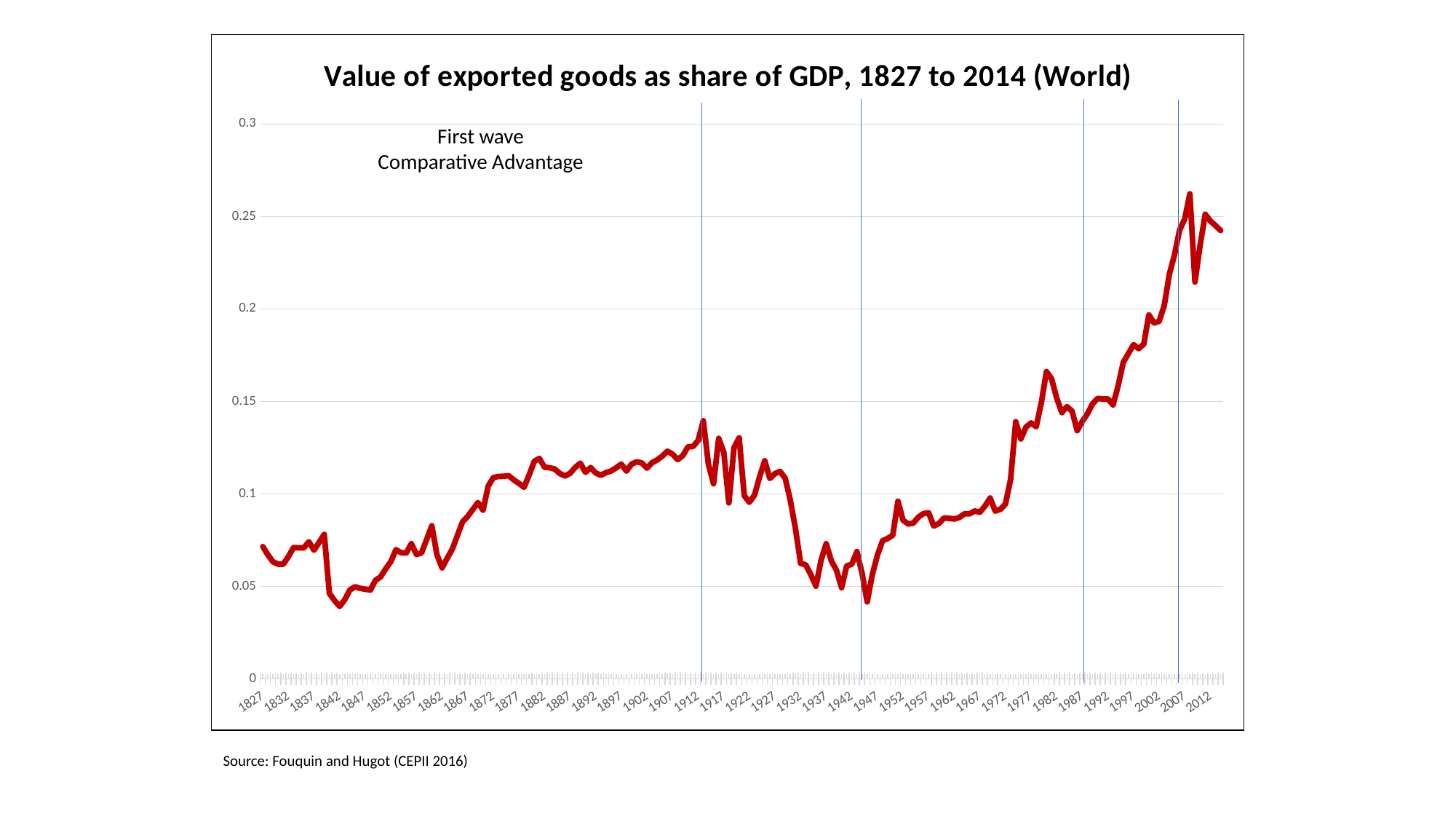
Does the value generally rise or fall between 1912 and 1947? fall What kind of chart is shown on the slide? line chart Is the value for 2012 greater or less than 0.2? greater What annotation text is written inside the plot area near the top left? First wave Comparative Advantage Is the value for 1827 greater or less than 0.1? less Is the value for 1947 greater or less than 0.05? greater What is the title of the chart? Value of exported goods as share of GDP, 1827 to 2014 (World) Does the value generally rise or fall between 1947 and 2007? rise